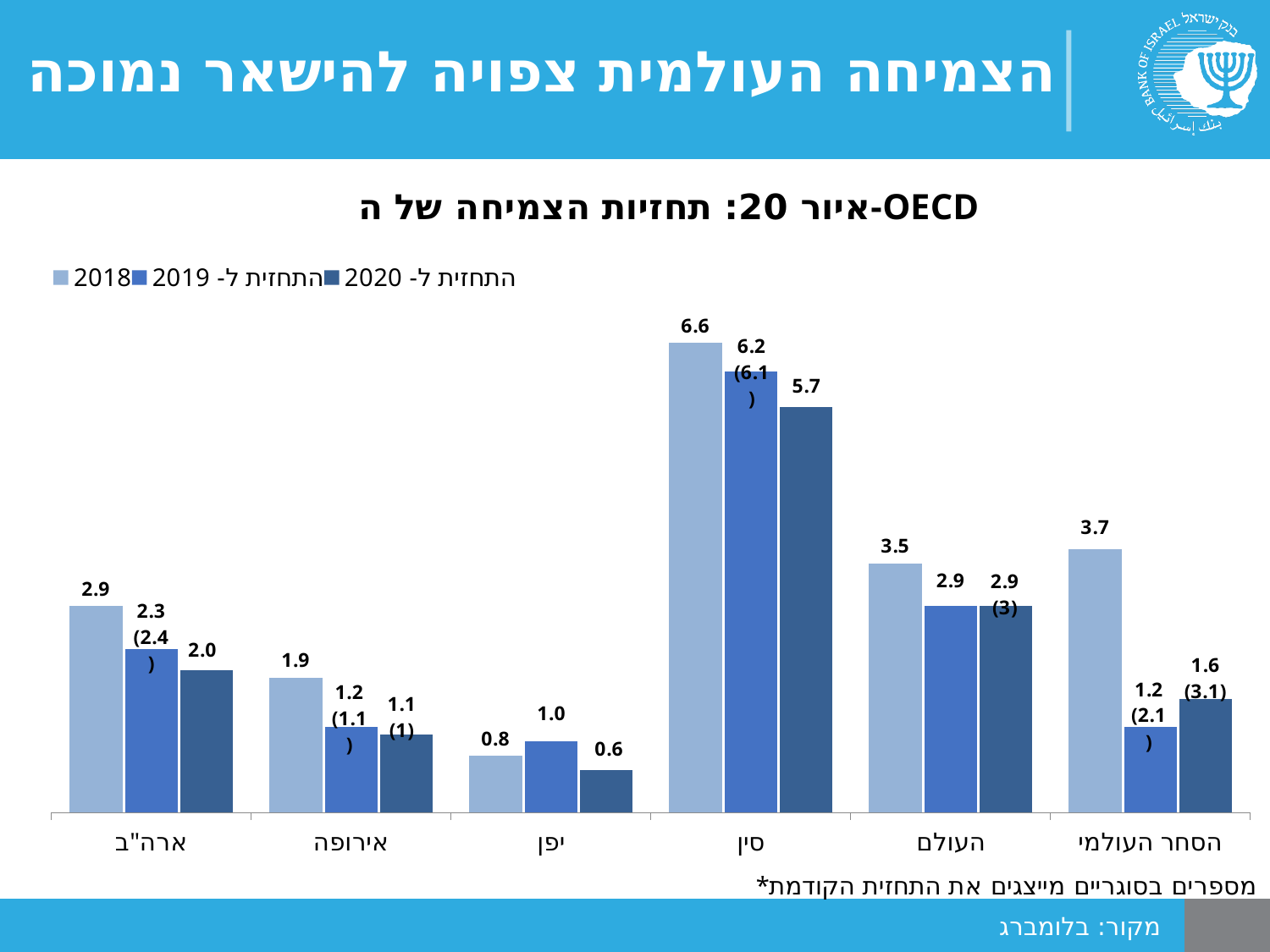
What is the 2018 value for הסחר העולמי (world trade)? 3.7 What kind of chart is this? bar chart What is the difference between the 2018 value and the forecast for 2019 for הסחר העולמי (world trade)? 2.5 Which category has the highest 2018 value? סין What is the forecast for 2019 (התחזית ל- 2019) for יפן (Japan)? 1.0 Which category has the lowest forecast for 2020 (התחזית ל- 2020)? יפן How many categories are shown on the x axis? 6 What is the 2018 value for סין (China)? 6.6 What is the forecast for 2020 (התחזית ל- 2020) for ארה"ב (USA)? 2.0 Which is larger for העולם (world): the 2018 value or the forecast for 2019? 2018 What is the difference between the 2018 value and the forecast for 2020 for סין (China)? 0.9 How many series does the legend list? 3